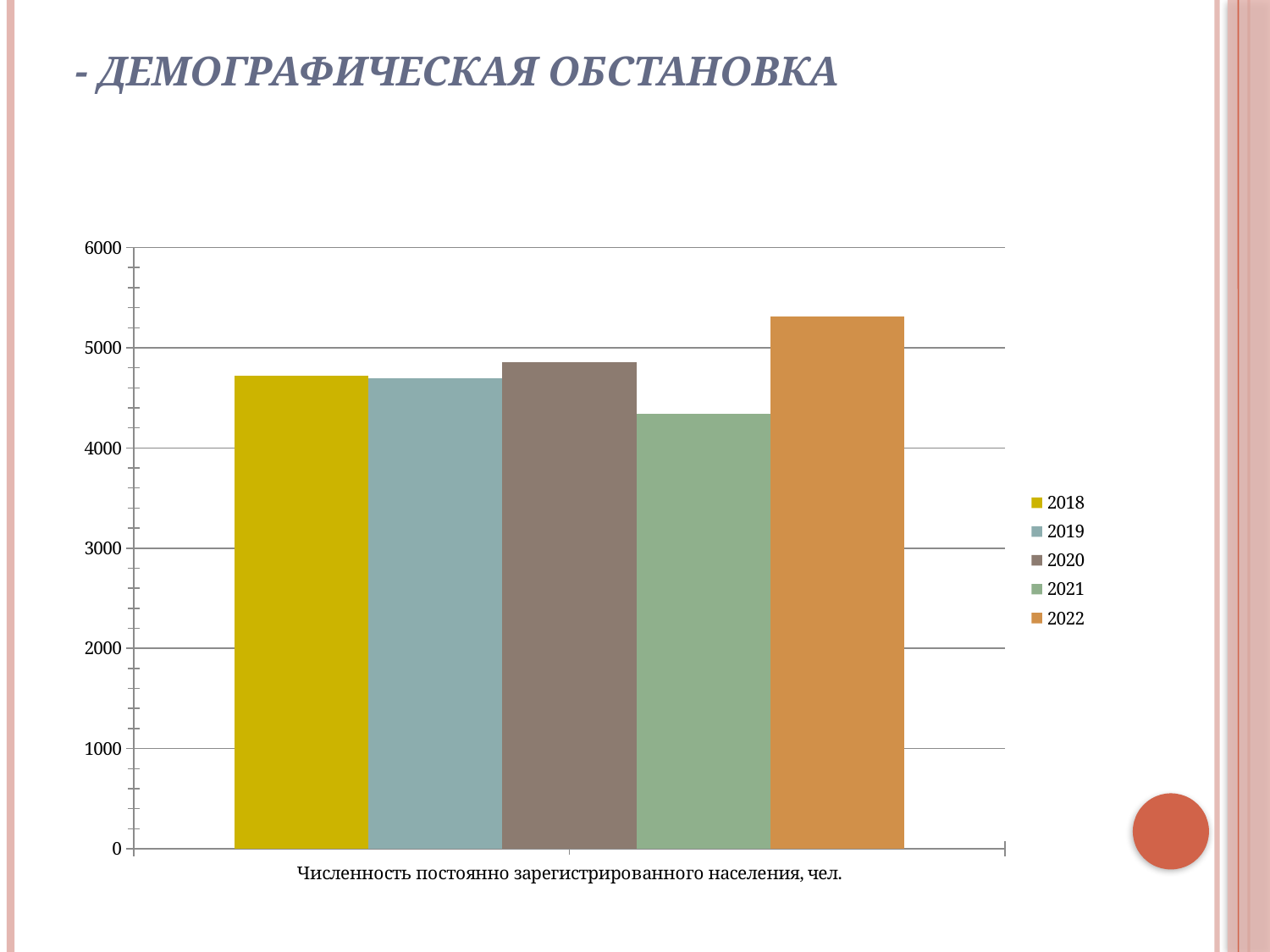
Which is larger, the value for 2022 or the value for 2018? 2022 Is the value for 2021 greater or less than 4000? greater How many categories are shown on the x axis? 1 Which year has the lowest value for Численность постоянно зарегистрированного населения? 2021 Is the value for 2022 greater or less than 5000? greater Is the value for 2020 greater or less than 5000? less What kind of chart is shown on the slide? bar chart What is the label of the category on the x axis? Численность постоянно зарегистрированного населения, чел. Which is larger, the value for 2020 or the value for 2021? 2020 How many series does the legend list? 5 Which year has the highest value for Численность постоянно зарегистрированного населения? 2022